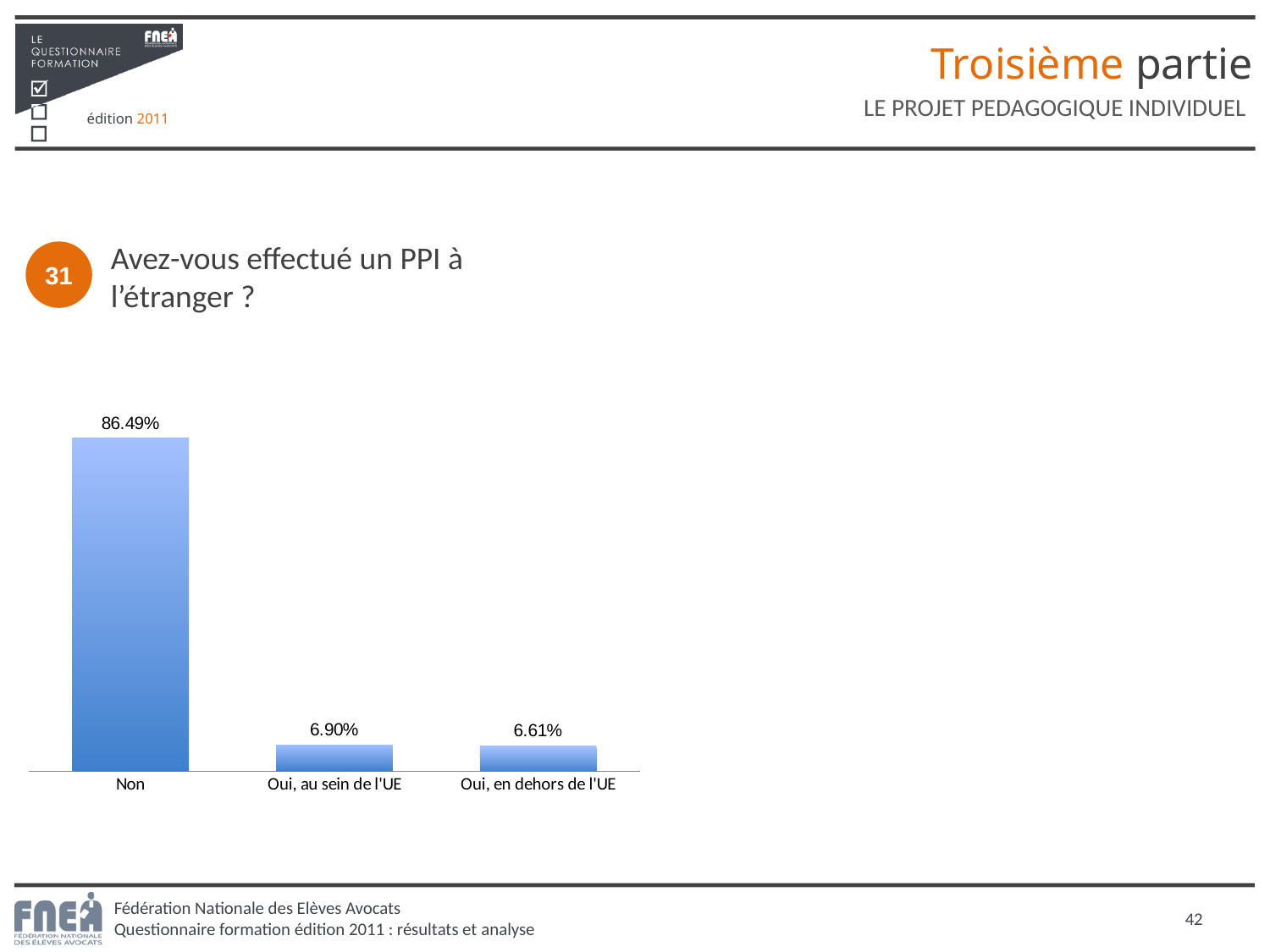
What is the difference between the values for "Non" and "Oui, au sein de l'UE"? 79.59% What is the value shown for "Oui, au sein de l'UE"? 6.90% What survey question does the chart on the slide answer? Avez-vous effectué un PPI à l'étranger ? Which category has the lowest value in the chart? Oui, en dehors de l'UE Which is larger: the value for "Oui, au sein de l'UE" or for "Oui, en dehors de l'UE"? Oui, au sein de l'UE What is the difference between the values for "Oui, au sein de l'UE" and "Oui, en dehors de l'UE"? 0.29% What kind of chart is shown on the slide? Bar chart Which category has the highest value in the chart? Non Do the values rise or fall from left to right across the categories? Fall What percentage of respondents answered "Non" to whether they did a PPI abroad? 86.49% How many categories are shown in the chart? 3 What is the value shown for "Oui, en dehors de l'UE"? 6.61%